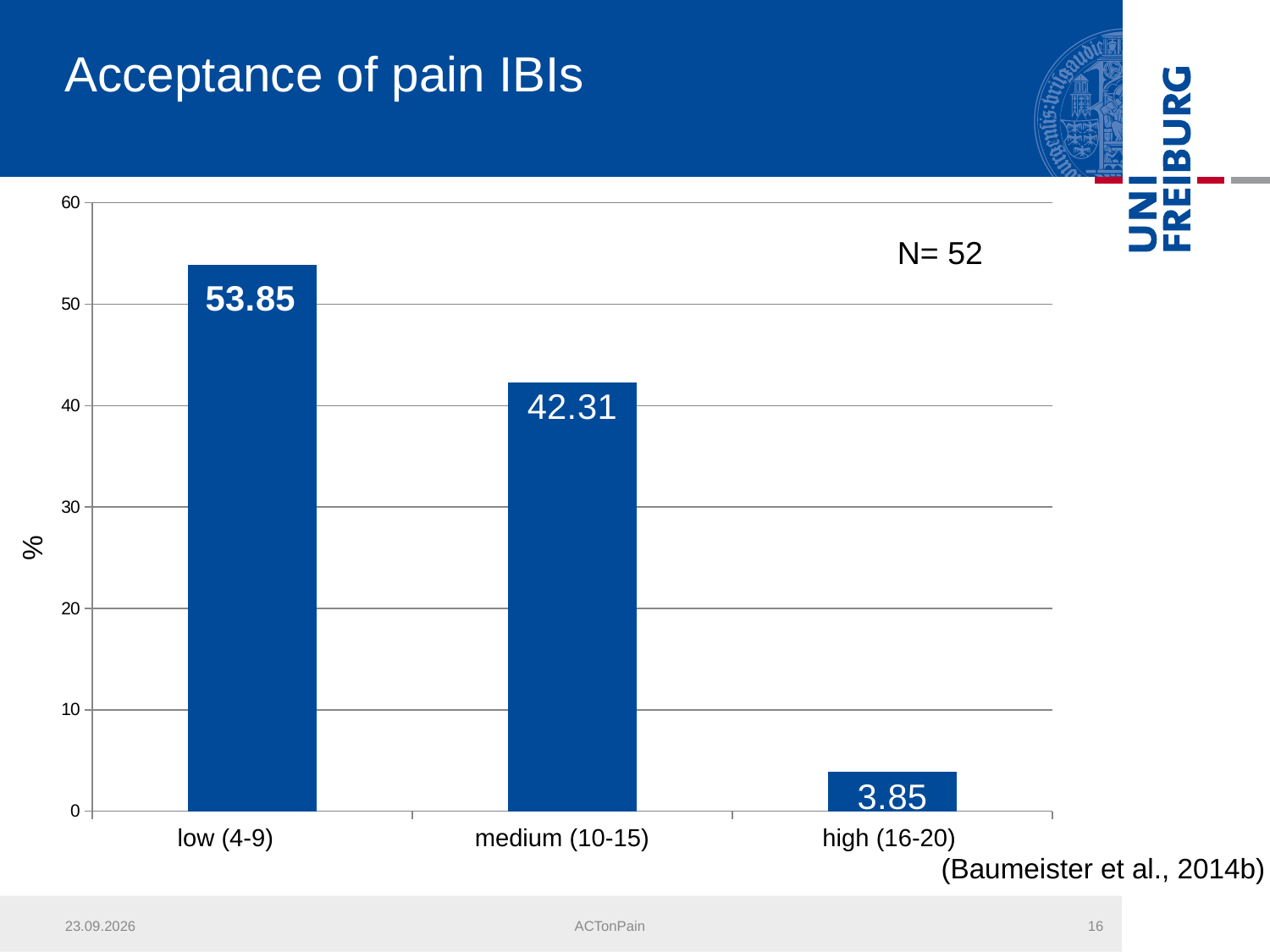
What is the value for the medium (10-15) category? 42.31 Which category has the lowest value? high (16-20) Is the value for low (4-9) greater or less than 50? greater Do the values rise or fall from left to right along the x axis? fall Which category has the highest value? low (4-9) Which is larger, the value for medium (10-15) or the value for high (16-20)? medium (10-15) What kind of chart is shown on the slide? bar chart What is the value for the low (4-9) category? 53.85 What is the difference between the values for low (4-9) and medium (10-15)? 11.54 How many categories are shown on the x axis? 3 What is the difference between the values for medium (10-15) and high (16-20)? 38.46 What is the value for the high (16-20) category? 3.85